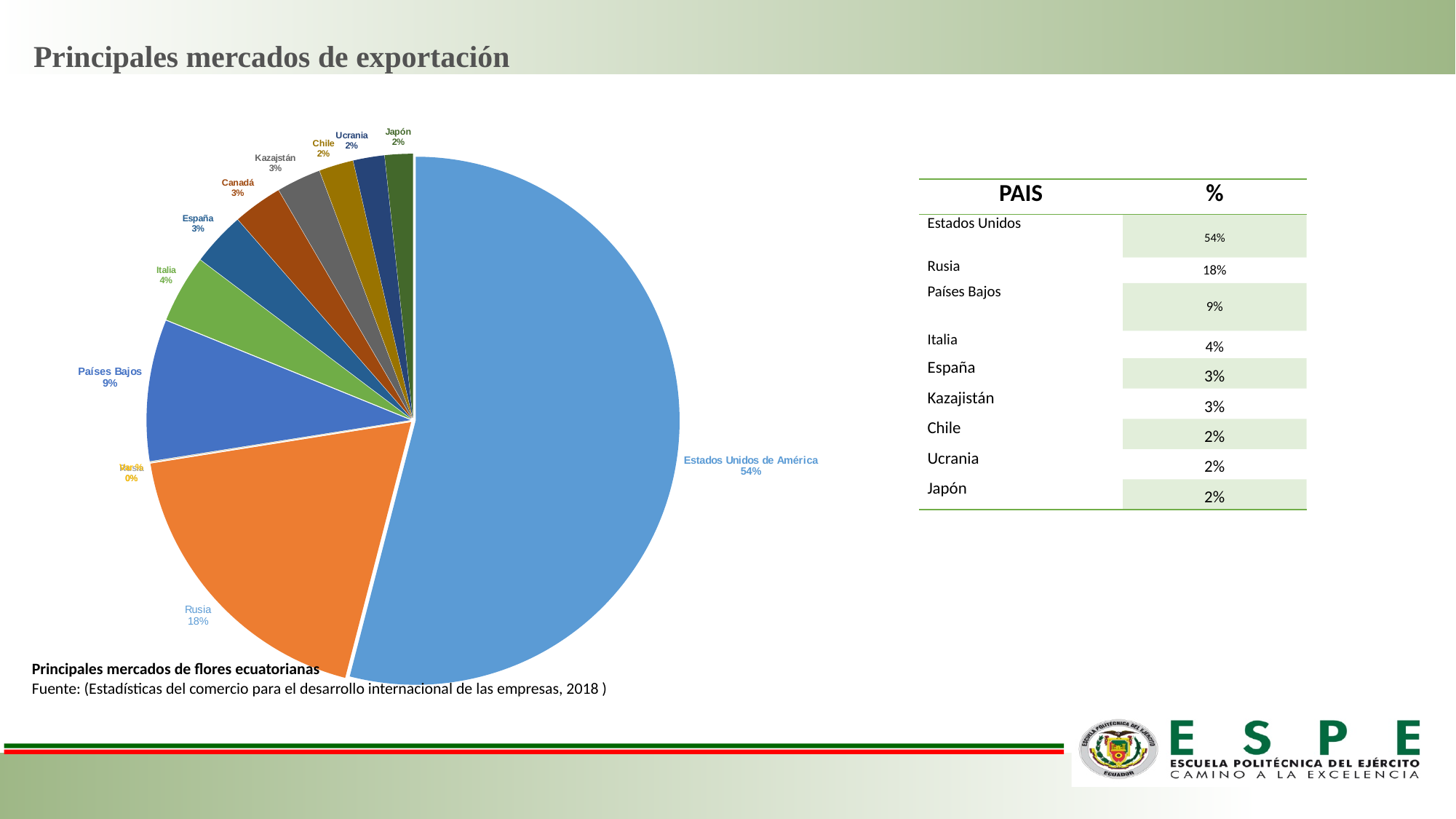
Which is larger in the pie chart, Rusia or Países Bajos? Rusia What is the value shown for Rusia in the pie chart? 18% By how many percentage points does Estados Unidos de América exceed Rusia in the pie chart? 36 What is the value shown for Japón in the pie chart? 2% What kind of chart is shown on the slide? pie chart What is the value shown for Canadá in the pie chart? 3% What is the value shown for Países Bajos in the pie chart? 9% Which is larger in the pie chart, Italia or Kazajistán? Italia Which market has the largest slice of the pie chart? Estados Unidos de América What is the value shown for Italia in the pie chart? 4% What is the caption printed below the pie chart? Principales mercados de flores ecuatorianas What share of the pie does Estados Unidos de América hold? 54%